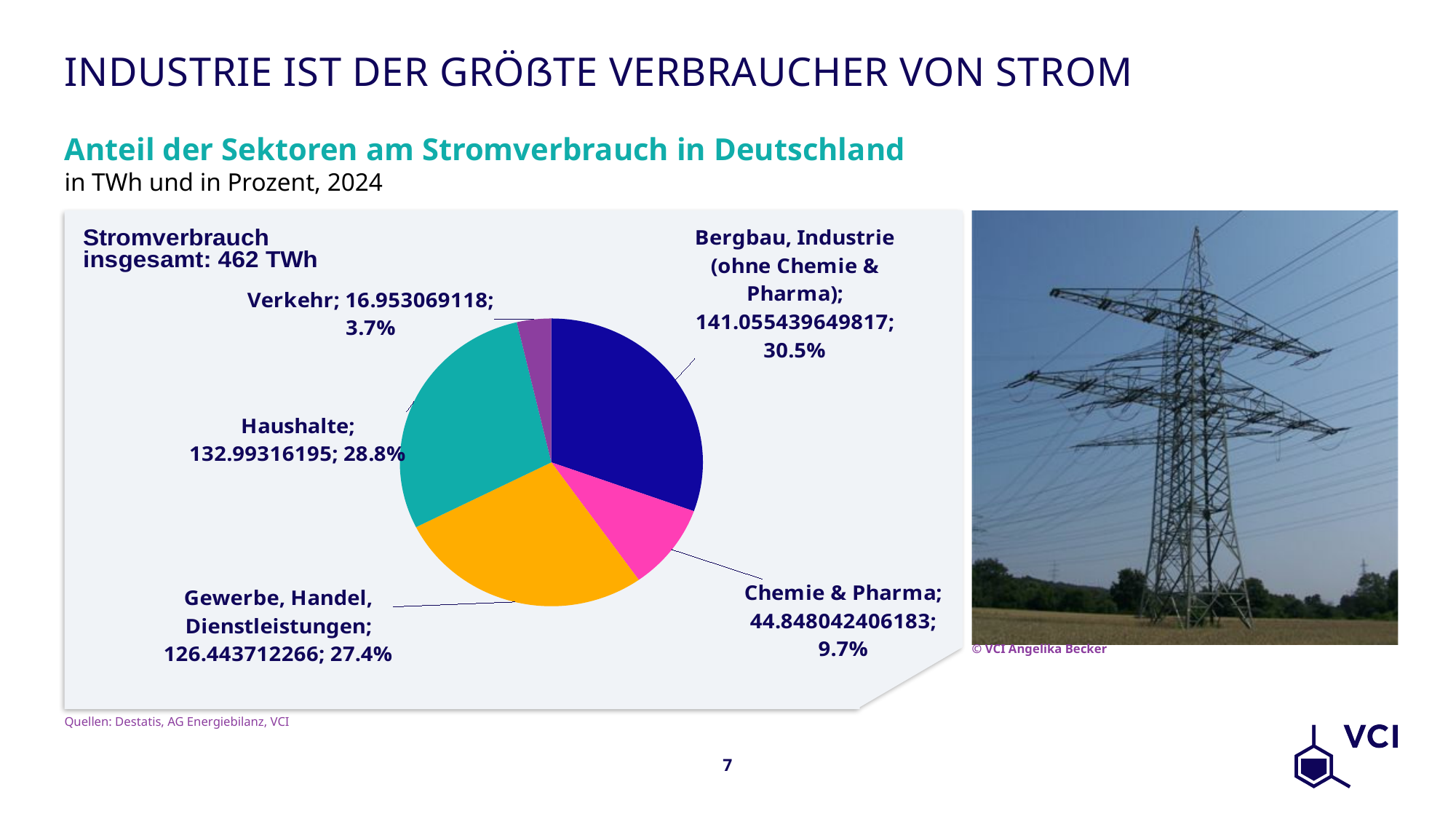
What total electricity consumption (Stromverbrauch insgesamt) is stated on the chart? 462 TWh How many sectors (slices) does the pie chart show? 5 Which has the larger share: Haushalte or Gewerbe, Handel, Dienstleistungen? Haushalte What value in TWh is shown for Gewerbe, Handel, Dienstleistungen? 126.443712266 Which sector has the largest share of electricity consumption? Bergbau, Industrie (ohne Chemie & Pharma) What percentage is shown for Bergbau, Industrie (ohne Chemie & Pharma)? 30.5% What share of the pie does Verkehr account for? 3.7% What is the value in TWh shown for Chemie & Pharma? 44.848042406183 What is the difference in percentage points between the shares of Bergbau, Industrie (ohne Chemie & Pharma) and Chemie & Pharma? 20.8 percentage points What share of electricity consumption does the Haushalte slice represent? 28.8% Which sector has the smallest share of electricity consumption? Verkehr What kind of chart is shown on the slide? pie chart